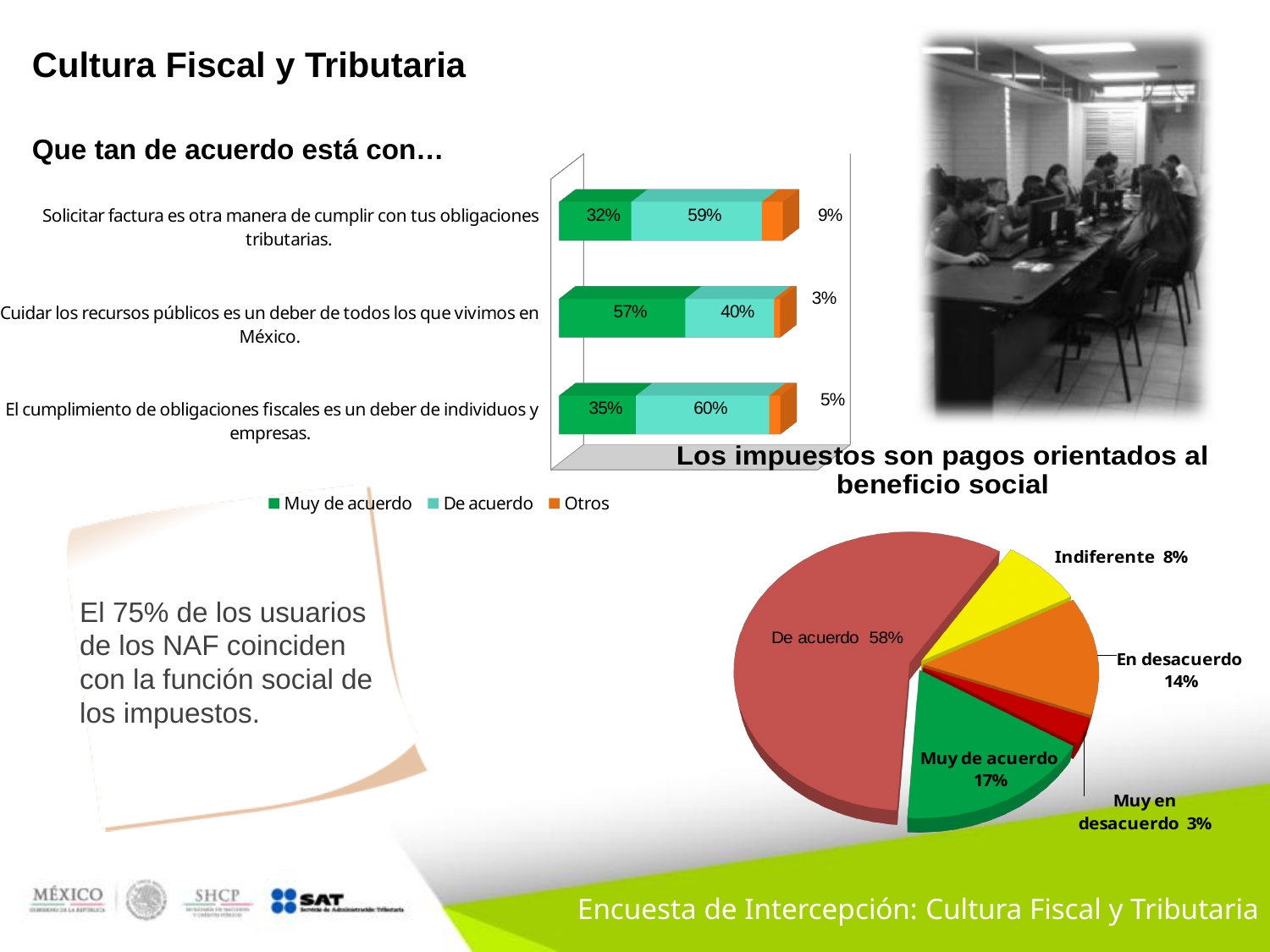
In the pie chart 'Los impuestos son pagos orientados al beneficio social', which slice is the largest? De acuerdo In the stacked bar chart, what is the 'De acuerdo' value for 'Solicitar factura es otra manera de cumplir con tus obligaciones tributarias'? 59% In the stacked bar chart, how many statements are plotted? 3 In the pie chart 'Los impuestos son pagos orientados al beneficio social', which slice is the smallest? Muy en desacuerdo In the stacked bar chart, what is the difference between the 'De acuerdo' values for 'El cumplimiento de obligaciones fiscales...' and 'Cuidar los recursos públicos...'? 20% In the pie chart 'Los impuestos son pagos orientados al beneficio social', what is the share for 'En desacuerdo'? 14% In the stacked bar chart, which statement has the highest 'Muy de acuerdo' value? Cuidar los recursos públicos es un deber de todos los que vivimos en México In the stacked bar chart, what is the 'Otros' value for 'El cumplimiento de obligaciones fiscales es un deber de individuos y empresas'? 5% In the stacked bar chart, how many series does the legend list? 3 In the stacked bar chart, what is the 'Muy de acuerdo' value for 'Cuidar los recursos públicos es un deber de todos los que vivimos en México'? 57% In the stacked bar chart, which statement has the lowest 'Otros' value? Cuidar los recursos públicos es un deber de todos los que vivimos en México In the pie chart 'Los impuestos son pagos orientados al beneficio social', how many slices are there? 5